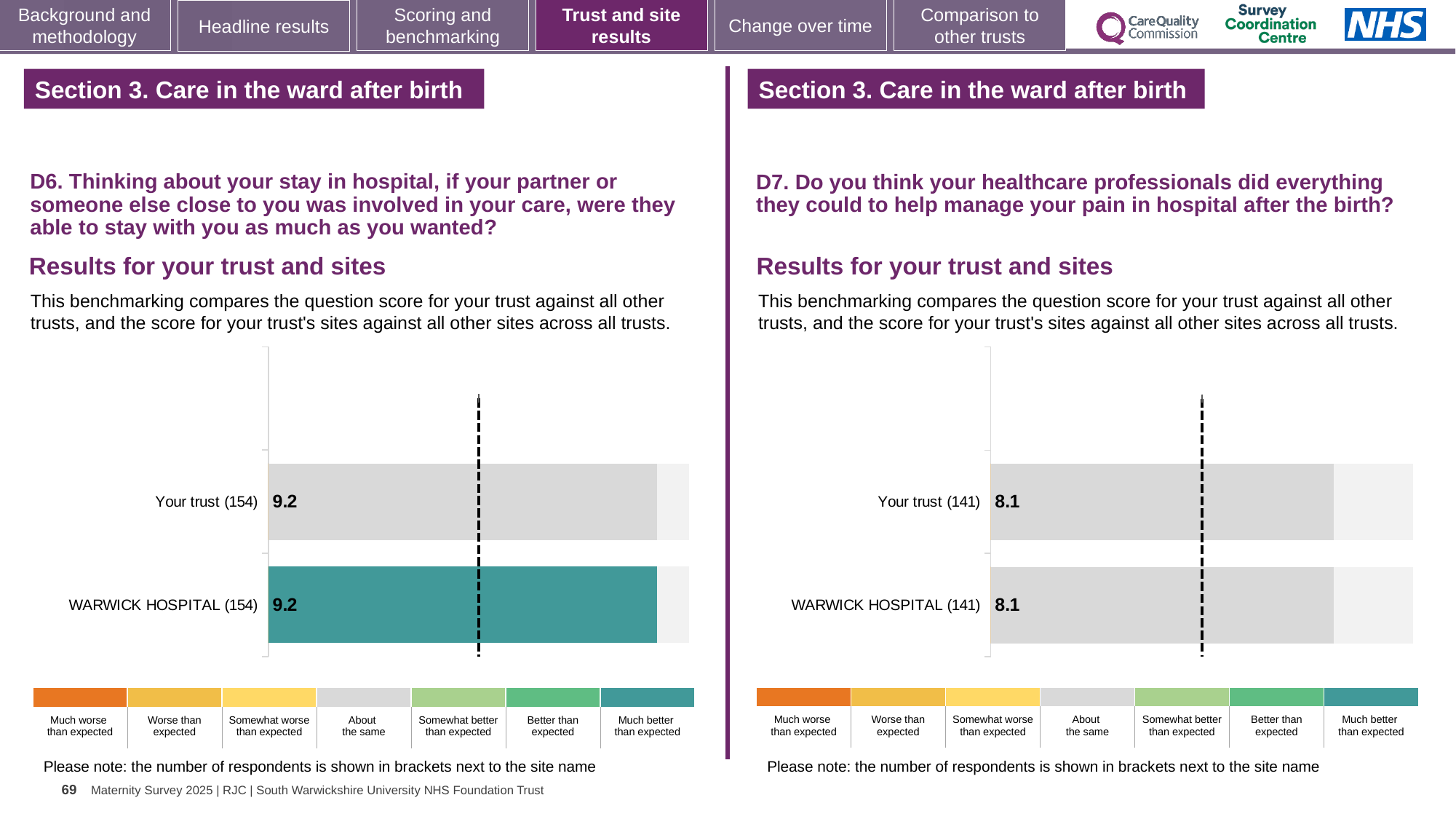
In the D6 chart on the left, what is the difference between the Your trust score and the WARWICK HOSPITAL score? 0 In the D6 chart on the left, which benchmark category does the colour of the WARWICK HOSPITAL bar correspond to? Much better than expected In the D7 chart on the right, how many respondents are shown in brackets for Your trust? 141 In the D6 chart on the left, how many respondents are shown in brackets for WARWICK HOSPITAL? 154 In the D6 chart on the left, what is the score for Your trust? 9.2 In the D6 chart on the left, what is the score for WARWICK HOSPITAL? 9.2 In the D7 chart on the right, what is the score for Your trust? 8.1 What type of chart is used in the D6 chart on the left? Bar chart In the D7 chart on the right, what is the score for WARWICK HOSPITAL? 8.1 How many bars are plotted in the D7 chart on the right? 2 In the D7 chart on the right, which benchmark category does the colour of the WARWICK HOSPITAL bar correspond to? About the same What is the difference between the Your trust score in the D6 chart on the left and the Your trust score in the D7 chart on the right? 1.1